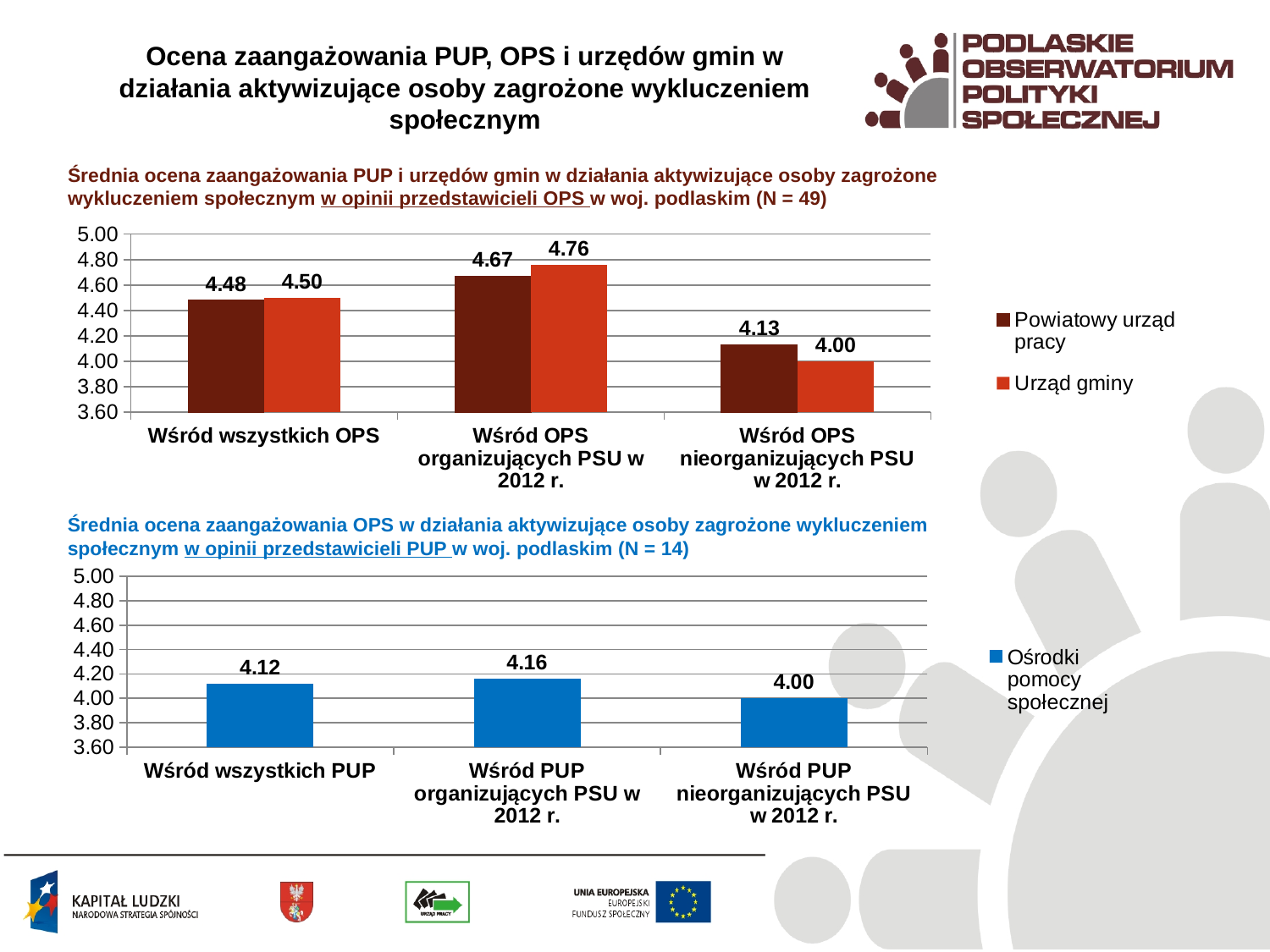
In the bottom chart, what is the difference between the values for 'Wśród wszystkich PUP' and 'Wśród PUP nieorganizujących PSU w 2012 r.'? 0.12 In the top chart, which category has the lowest value for Urząd gminy? Wśród OPS nieorganizujących PSU w 2012 r. How many categories are shown on the x axis of the bottom chart? 3 In the bottom chart, which category has the highest value? Wśród PUP organizujących PSU w 2012 r. In the top chart, what is the value for Powiatowy urząd pracy in the category 'Wśród wszystkich OPS'? 4.48 In the top chart, what is the difference between the Urząd gminy and Powiatowy urząd pracy values in the category 'Wśród OPS nieorganizujących PSU w 2012 r.'? 0.13 In the top chart, what is the value for Urząd gminy in the category 'Wśród OPS organizujących PSU w 2012 r.'? 4.76 How many series does the legend of the top chart list? 2 In the top chart, which is larger in the category 'Wśród OPS organizujących PSU w 2012 r.': Powiatowy urząd pracy or Urząd gminy? Urząd gminy In the bottom chart, what is the value for 'Wśród PUP organizujących PSU w 2012 r.'? 4.16 What is the legend entry of the bottom chart? Ośrodki pomocy społecznej What type of chart is the bottom chart? Bar chart